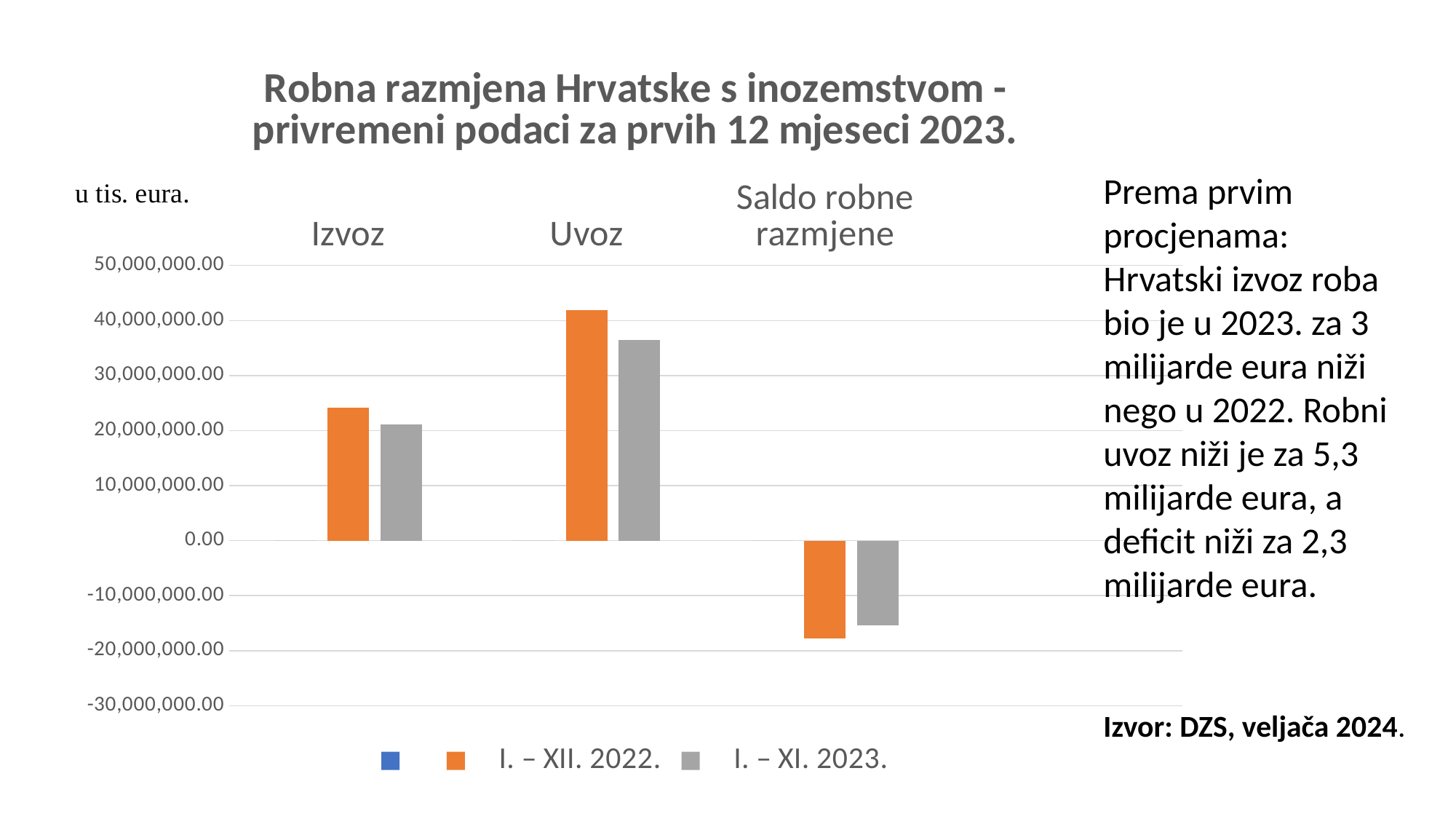
What kind of chart is shown on the slide? bar chart Is the value for Uvoz in the I. – XII. 2022. series greater or less than 40,000,000.00? greater Is the value for Izvoz in the I. – XII. 2022. series greater or less than 20,000,000.00? greater Which category has the tallest bar in the chart? Uvoz What unit is stated for the values in the chart? u tis. eura. Which colour represents the I. – XI. 2023. series in the chart? gray How many categories are shown on the x axis of the chart? 3 Is the value for Uvoz in the I. – XI. 2023. series greater or less than 40,000,000.00? less For Izvoz, which series has the larger value: I. – XII. 2022. or I. – XI. 2023.? I. – XII. 2022. Which category has the lowest (most negative) bar in the chart? Saldo robne razmjene For Uvoz, which series has the larger value: I. – XII. 2022. or I. – XI. 2023.? I. – XII. 2022.